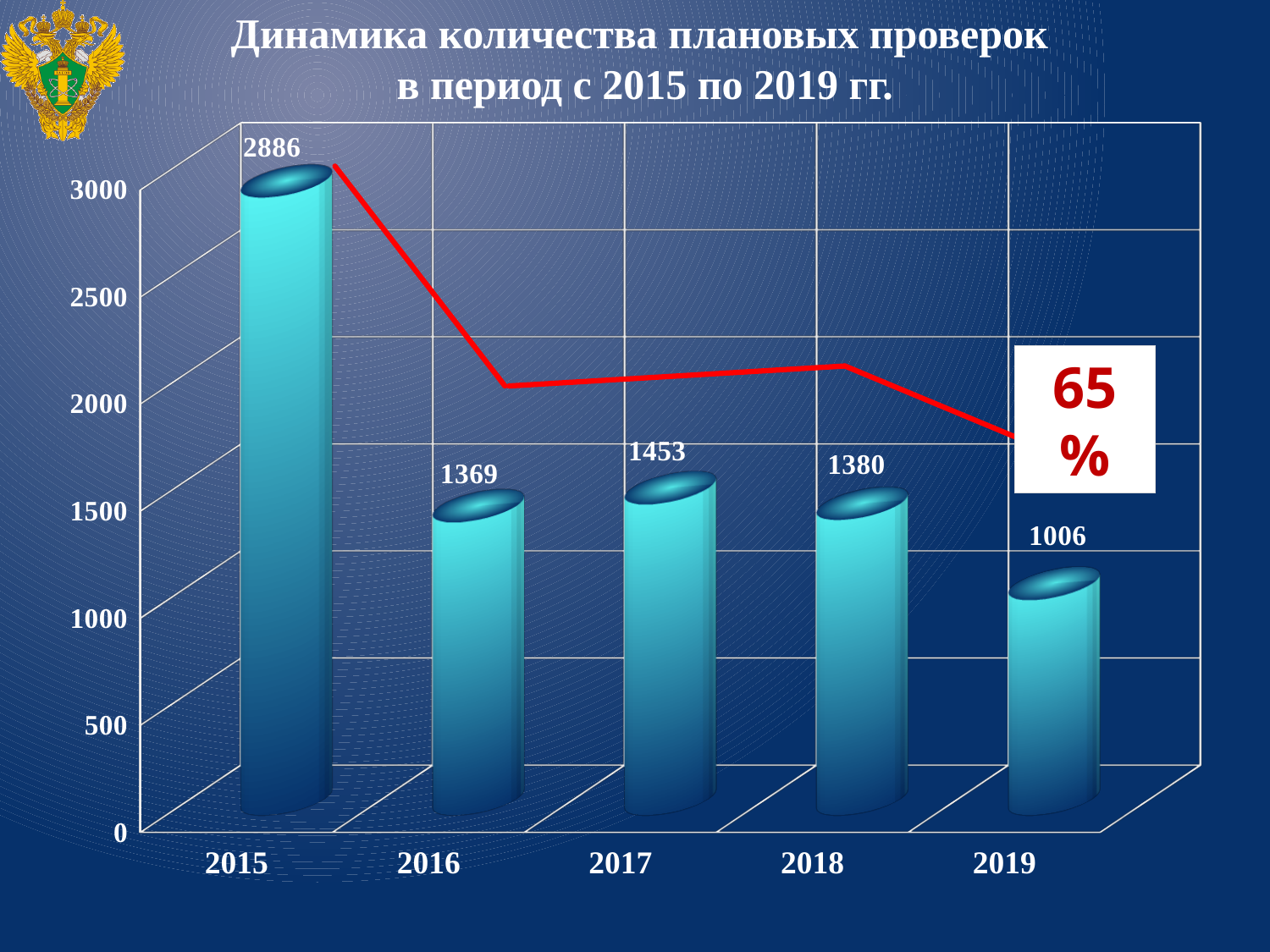
What is the difference between the values for 2015 and 2019? 1880 What is the value for 2015? 2886 What is the difference between the values for 2017 and 2016? 84 Which year has the lowest value? 2019 Is the value for 2016 greater or less than 1500? less How many years are shown on the x axis? 5 What percentage is shown in the white box on the chart? 65% What is the value for 2019? 1006 Which is larger, the value for 2017 or the value for 2018? 2017 Which year has the highest value? 2015 What kind of chart is this? bar chart What is the value for 2017? 1453